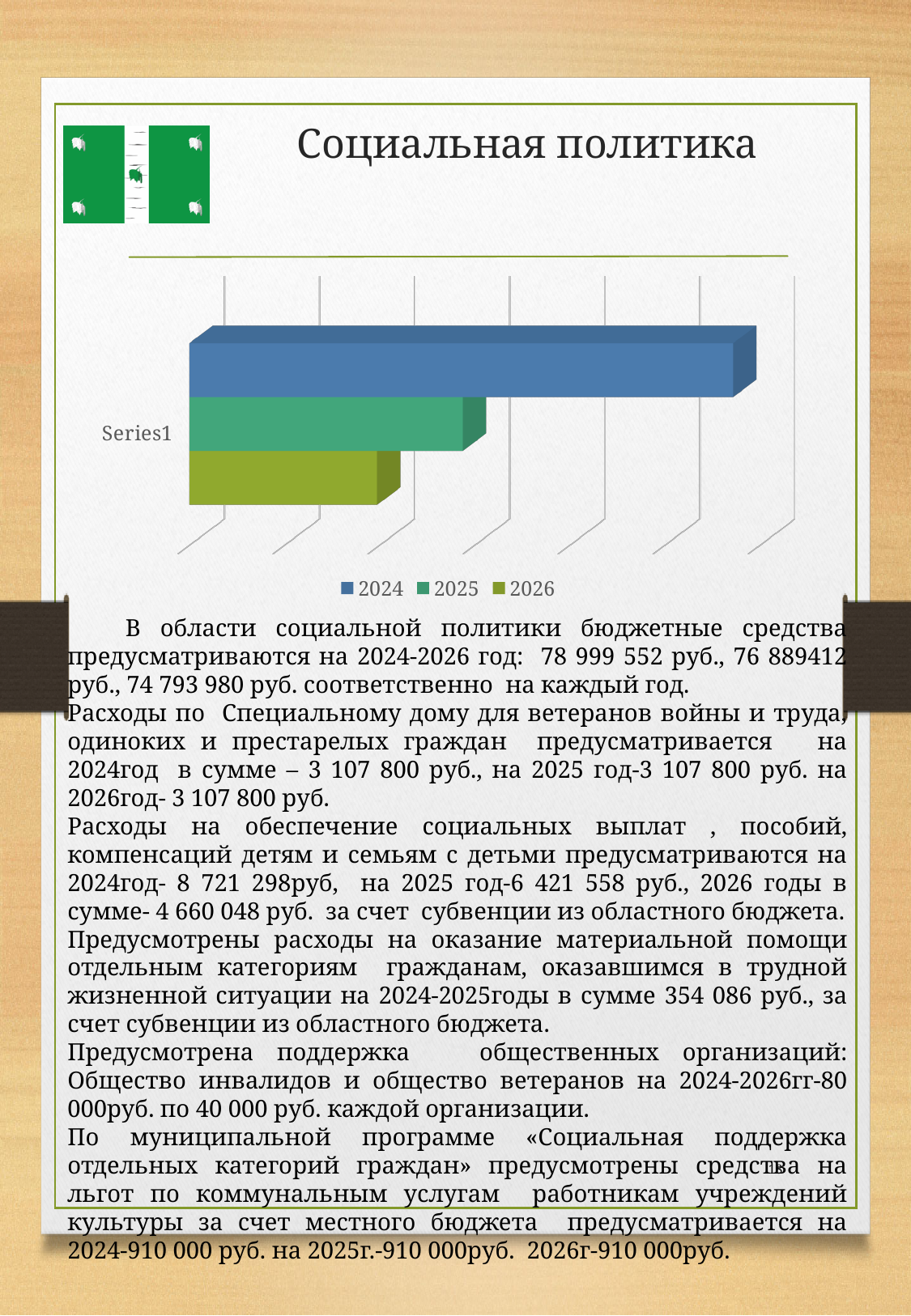
Do the bar lengths increase or decrease from the 2024 series to the 2026 series? decrease Which series has the shortest bar in the chart? 2026 Which series has the longest bar in the chart? 2024 Which bar is shorter, 2024 or 2026? 2026 What is the label of the category shown on the chart's vertical axis? Series1 What are the entries listed in the chart legend? 2024, 2025, 2026 Which bar is longer, 2024 or 2025? 2024 Which bar is longer, 2025 or 2026? 2025 How many categories are shown on the chart's vertical axis? 1 What kind of chart is shown on the slide? bar chart How many series does the chart legend list? 3